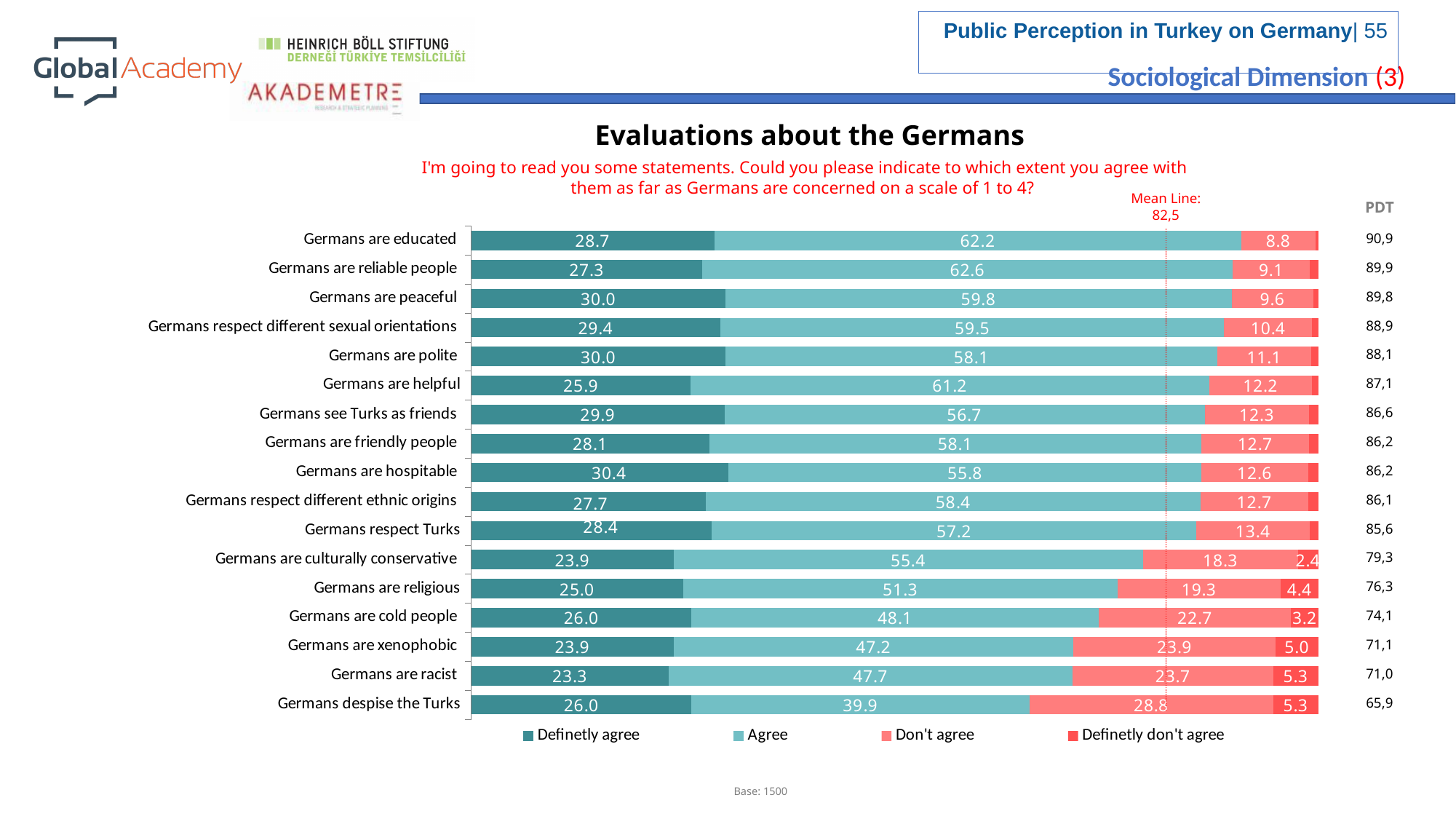
What is the "Agree" value for "Germans despise the Turks"? 39.9 Which statement has the highest "Agree" value? Germans are reliable people What is the "Definetly don't agree" value for "Germans are xenophobic"? 5.0 What is the difference between the "Don't agree" value for "Germans despise the Turks" and for "Germans are educated"? 20.0 How many statements (categories) are plotted in the chart? 17 What is the "Definetly agree" value for "Germans are educated"? 28.7 What is the "Don't agree" value for "Germans are religious"? 19.3 How many series does the legend list? 4 Which has the larger "Definetly agree" value: "Germans are hospitable" or "Germans are helpful"? Germans are hospitable What value is the mean line drawn at? 82,5 What kind of chart is shown on the slide? Stacked bar chart Which statement has the lowest "Agree" value? Germans despise the Turks